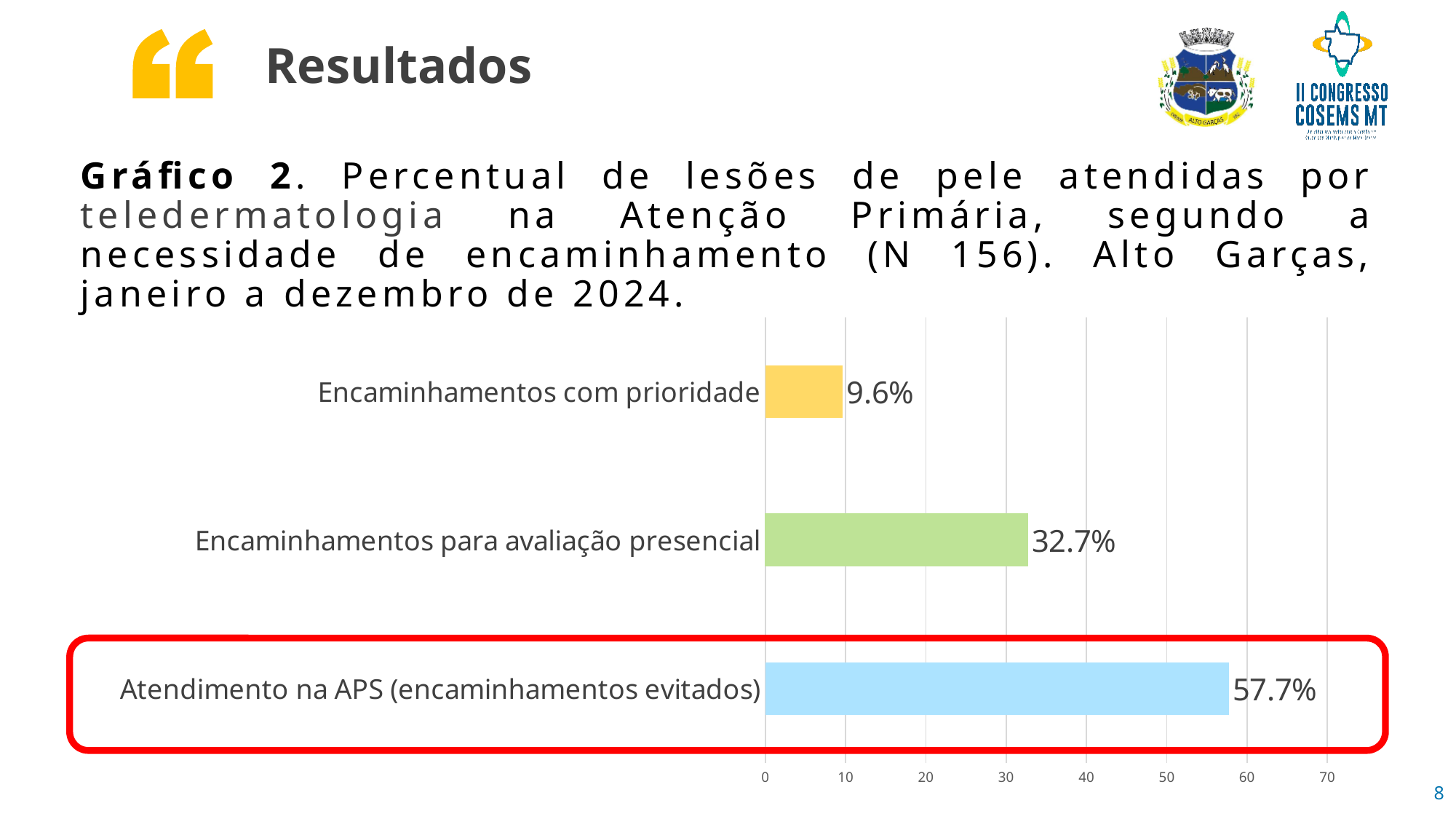
What is the value for Encaminhamentos para avaliação presencial? 32.7% What is the difference between the values for Atendimento na APS (encaminhamentos evitados) and Encaminhamentos para avaliação presencial? 25 percentage points Which category has the highest value? Atendimento na APS (encaminhamentos evitados) How many categories are shown in the chart? 3 Is the value for Encaminhamentos para avaliação presencial greater or less than 30? greater Which category is highlighted with a red outline on the slide? Atendimento na APS (encaminhamentos evitados) Which category has the lowest value? Encaminhamentos com prioridade Which is larger: the value for Encaminhamentos para avaliação presencial or the value for Encaminhamentos com prioridade? Encaminhamentos para avaliação presencial What kind of chart is shown on the slide? Bar chart What is the value for Atendimento na APS (encaminhamentos evitados)? 57.7% What is the difference between the values for Encaminhamentos para avaliação presencial and Encaminhamentos com prioridade? 23.1 percentage points What is the value for Encaminhamentos com prioridade? 9.6%